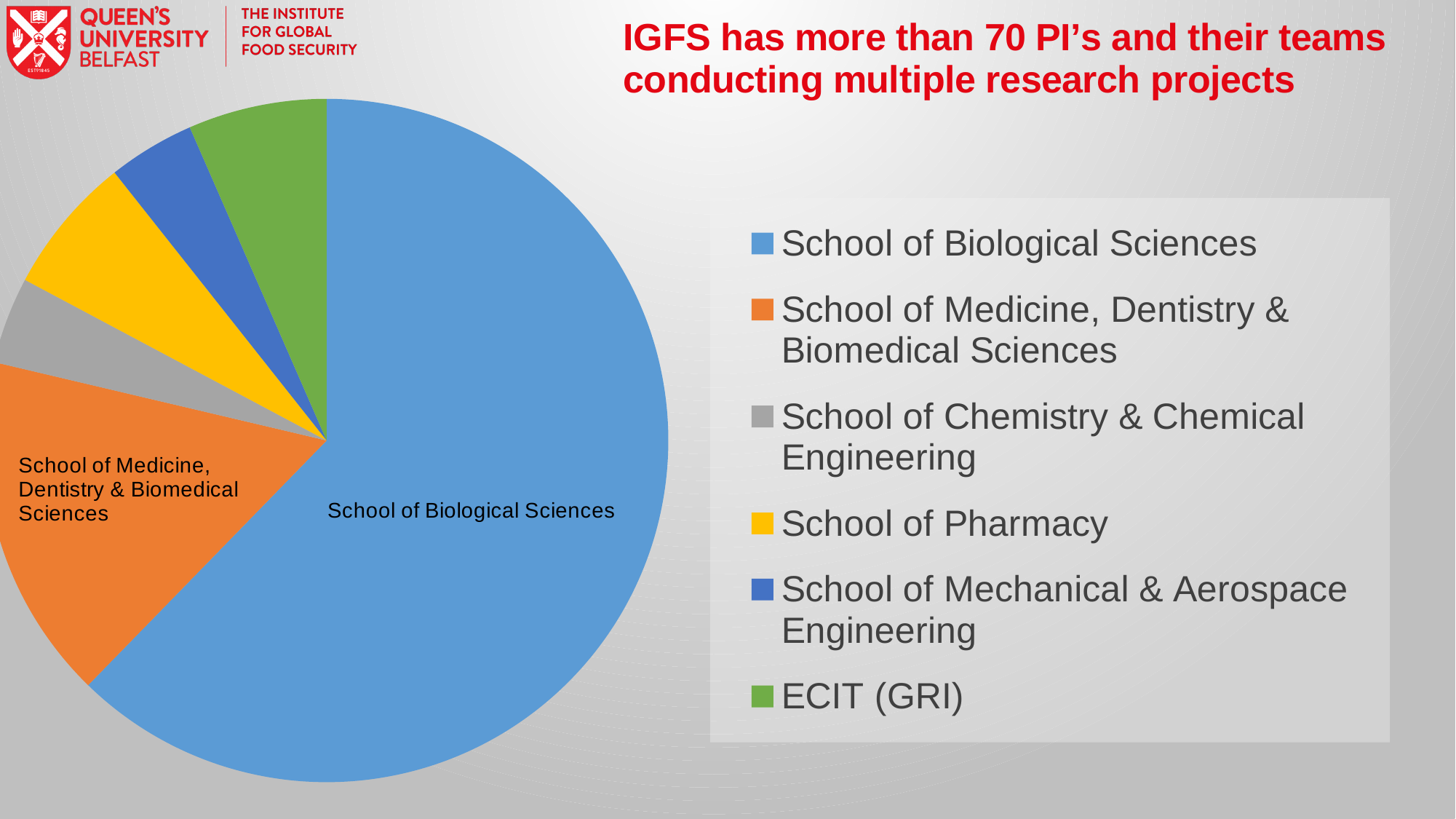
Which category is the second largest slice of the pie chart? School of Medicine, Dentistry & Biomedical Sciences Which slice is larger: ECIT (GRI) or School of Mechanical & Aerospace Engineering? ECIT (GRI) Which category is shown in green in the pie chart? ECIT (GRI) How many categories (slices) does the pie chart have? 6 Which slice is larger: School of Medicine, Dentistry & Biomedical Sciences or School of Pharmacy? School of Medicine, Dentistry & Biomedical Sciences Which slice is larger: School of Biological Sciences or School of Medicine, Dentistry & Biomedical Sciences? School of Biological Sciences Which category has the largest slice of the pie chart? School of Biological Sciences What colour is the slice for School of Pharmacy in the pie chart? yellow How many entries does the legend of the pie chart list? 6 What kind of chart is shown on the slide? pie chart